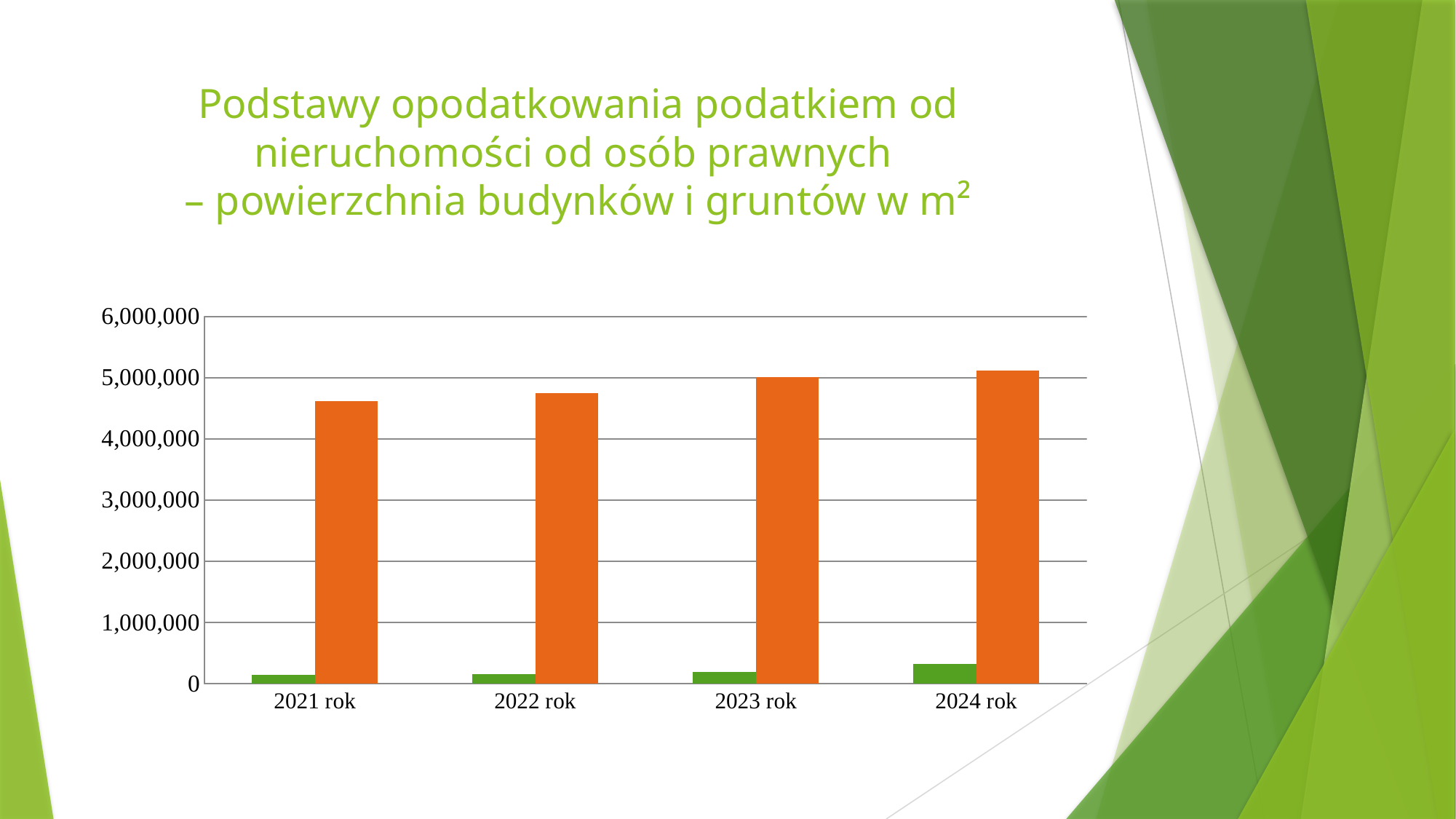
Which year has the shortest orange bar? 2021 rok Which is larger, the orange bar for 2021 rok or the orange bar for 2023 rok? 2023 rok Do the orange bars rise or fall from 2021 rok to 2024 rok? rise Is the orange bar for 2021 rok greater or less than 5,000,000? less What is the highest value shown on the vertical axis? 6,000,000 How many year categories are shown on the x axis? 4 Which year has the tallest green bar? 2024 rok Is the orange bar for 2024 rok greater or less than 5,000,000? greater Which year has the tallest orange bar? 2024 rok Is the green bar for 2024 rok greater or less than 1,000,000? less What kind of chart is shown on the slide? bar chart